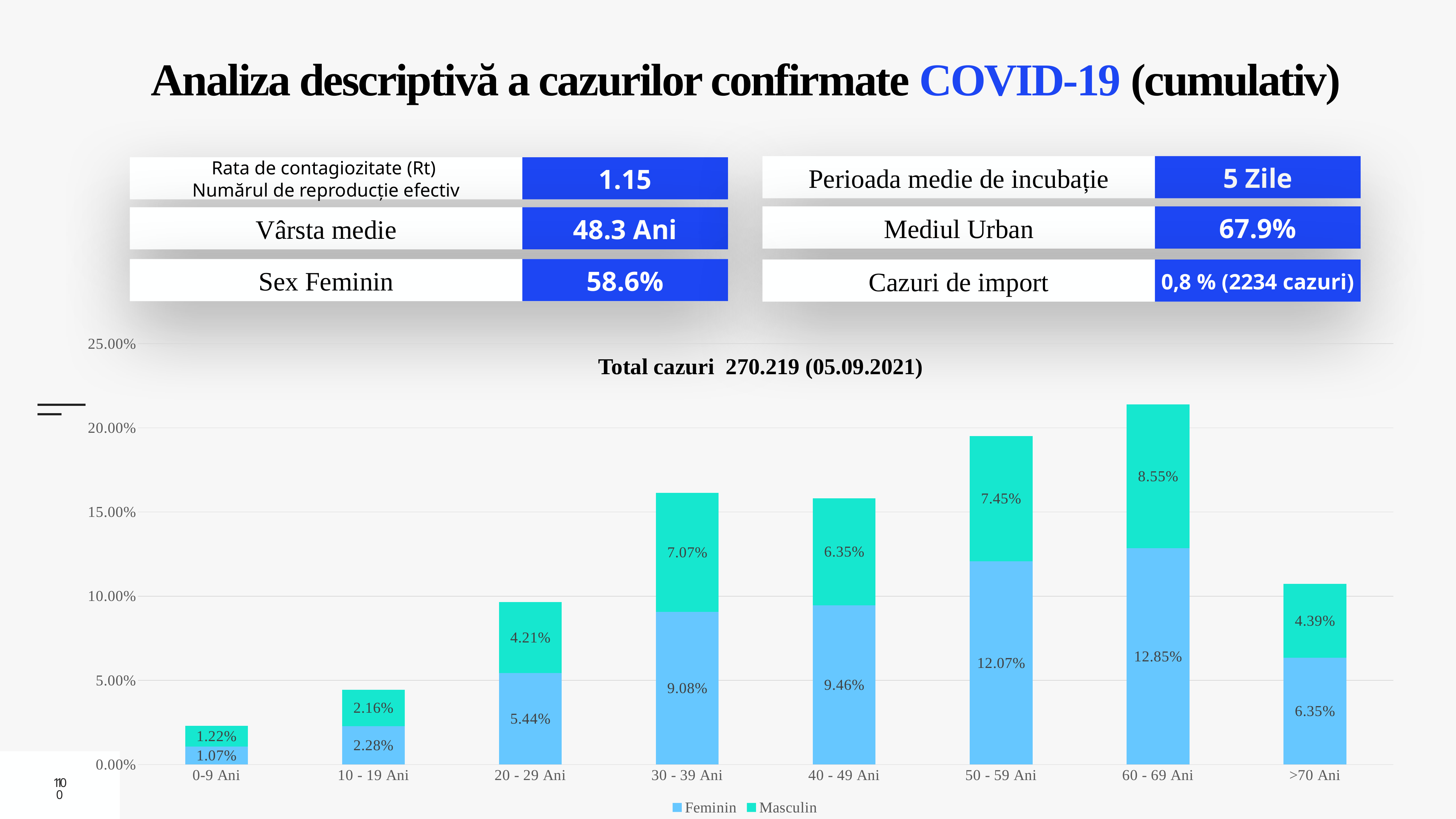
What is the Masculin value for the 30 - 39 Ani age group? 7.07% Which series is shown in the darker teal colour at the top of each bar? Masculin What is the difference between the Feminin values for 60 - 69 Ani and 50 - 59 Ani? 0.78% How many series does the legend list? 2 What is the Feminin value for the 60 - 69 Ani age group? 12.85% How many age groups are shown on the x axis? 8 Which is larger, the Masculin value for 20 - 29 Ani or the Masculin value for >70 Ani? 20 - 29 Ani What is the total of the stacked bar for the 60 - 69 Ani age group? 21.40% What kind of chart is shown on the slide? Stacked bar chart What is the Feminin value for the >70 Ani age group? 6.35% Which age group has the highest Feminin value? 60 - 69 Ani Which age group has the lowest Masculin value? 0-9 Ani